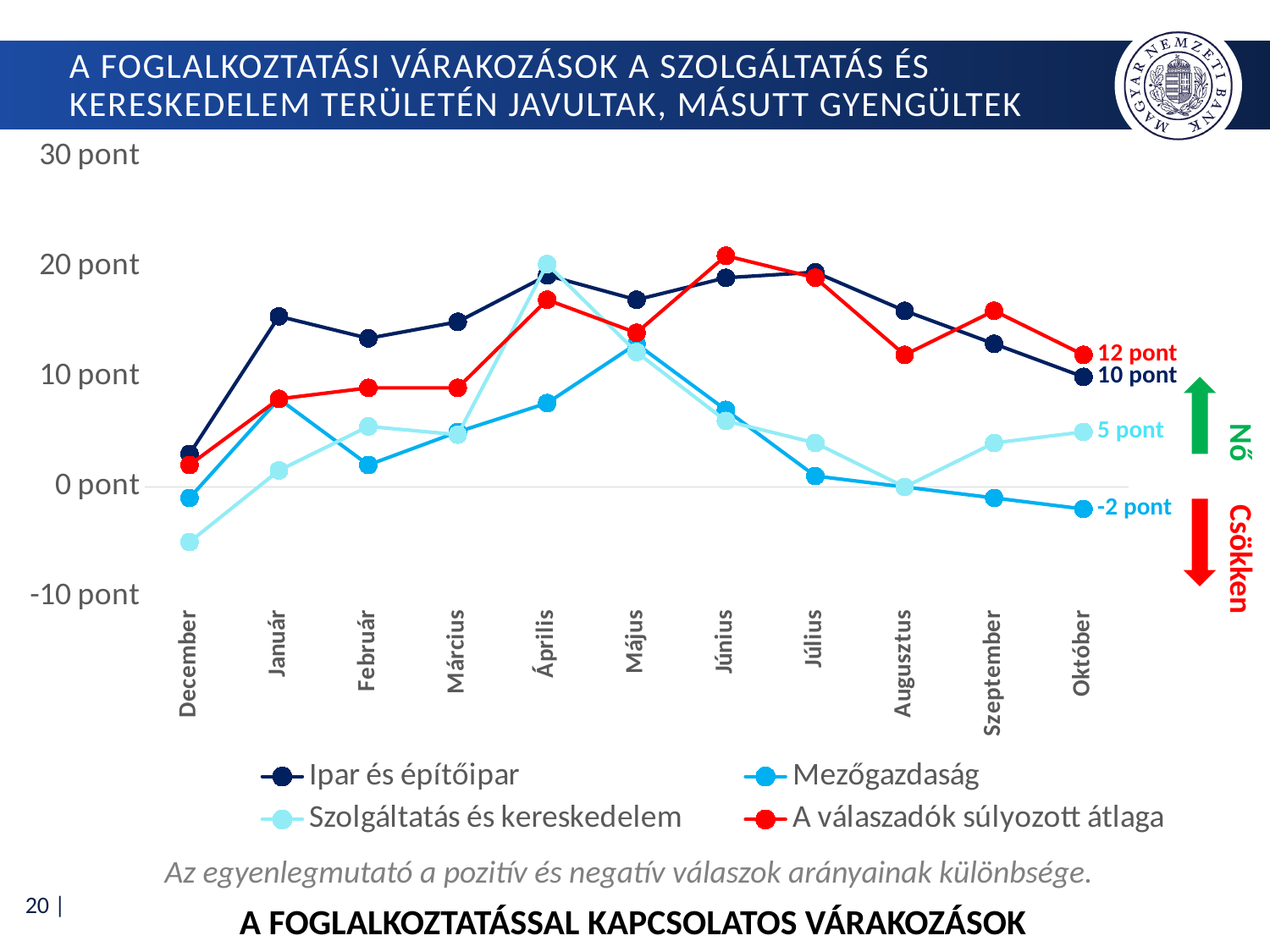
Is the value for Ipar és építőipar in Január greater or less than 10 pont? greater Which series has the lowest value in Október? Mezőgazdaság Which series has the highest value in Október? A válaszadók súlyozott átlaga How many series does the legend list? 4 In Október, what is the difference between A válaszadók súlyozott átlaga and Ipar és építőipar? 2 pont How many months are shown on the x axis? 11 What is the value for A válaszadók súlyozott átlaga in Október? 12 pont What is the value for Szolgáltatás és kereskedelem in Október? 5 pont What is the value for Mezőgazdaság in Október? -2 pont What kind of chart is shown on the slide? line chart Is the value for Szolgáltatás és kereskedelem in December greater or less than 0 pont? less What is the value for Ipar és építőipar in Október? 10 pont